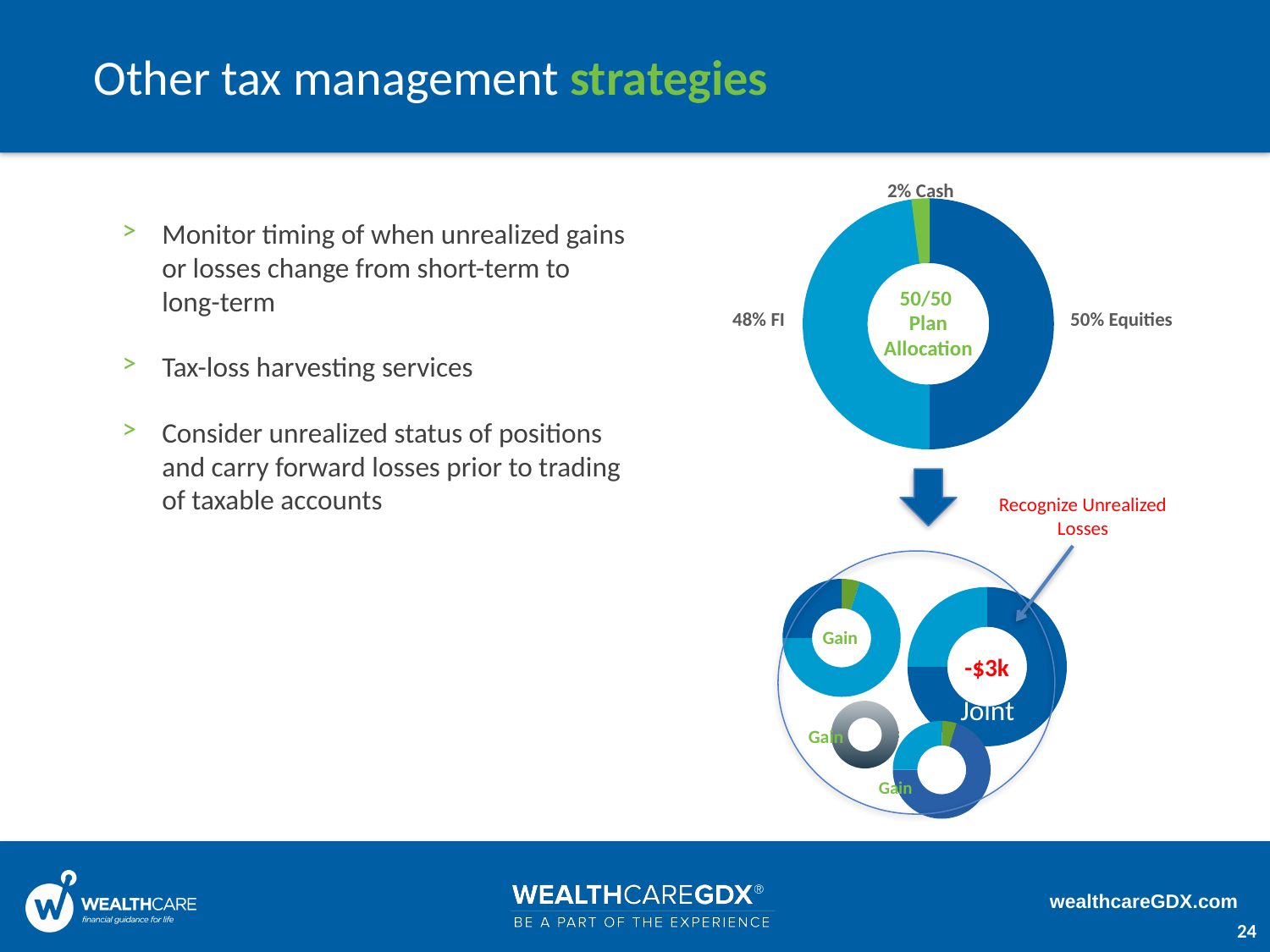
What kind of chart is the top chart on the right of the slide? Donut (pie) chart How many categories are shown in the top donut chart? 3 In the top donut chart, which category has the largest share? Equities What value is shown in the center of the Joint account donut in the lower chart group? -$3k In the top donut chart, what is the difference between the Equities share and the FI share? 2% In the top donut chart, what share of the plan allocation is FI? 48% In the top donut chart, what share of the plan allocation is Cash? 2% What is the total of the Equities and FI shares in the top donut chart? 98% In the top donut chart, which category has the smallest share? Cash In the top donut chart, what share of the plan allocation is Equities? 50% In the top donut chart, which is larger, the FI share or the Cash share? FI What text appears in the center of the top donut chart? 50/50 Plan Allocation